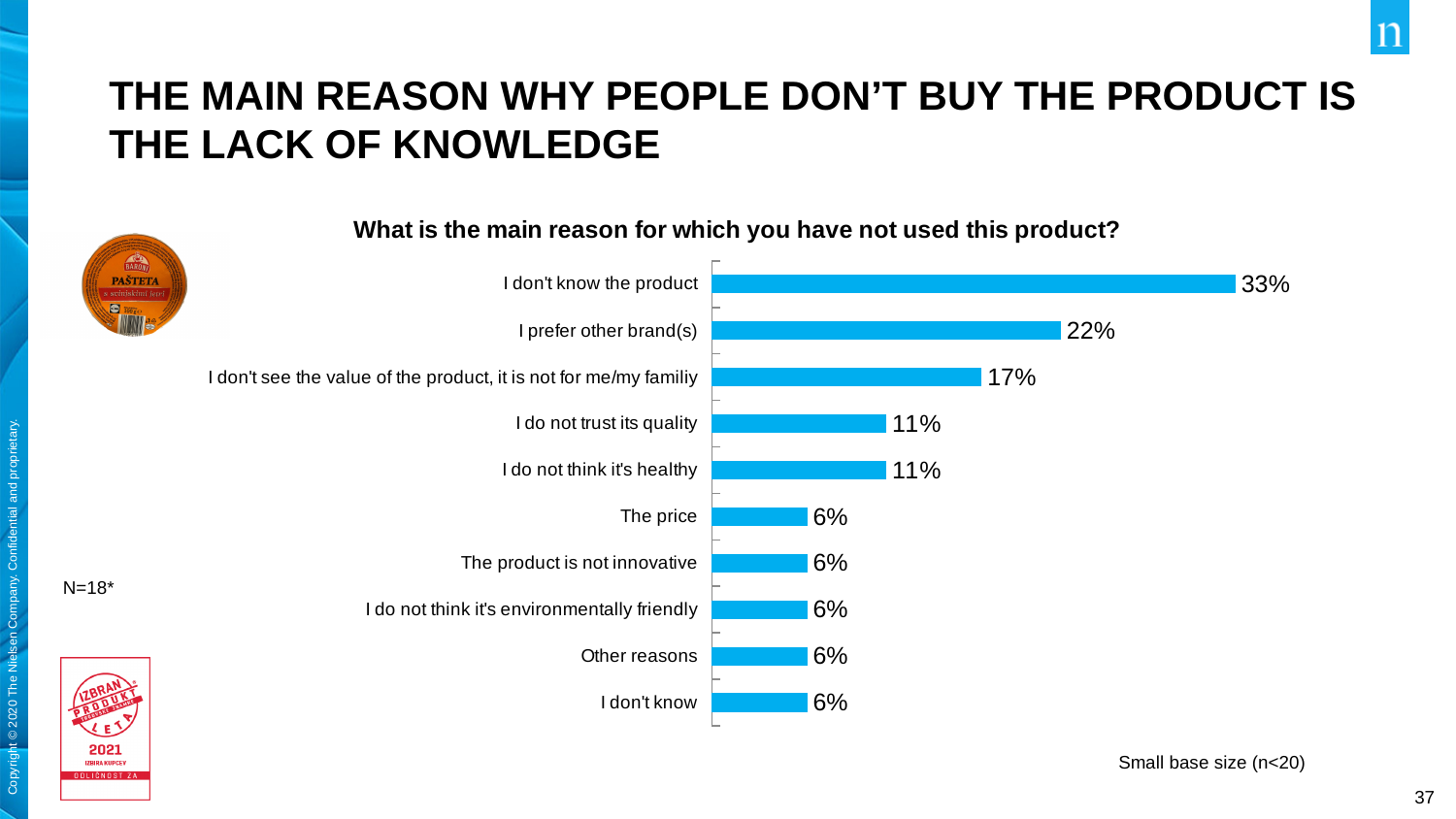
What is the difference between "I don't know the product" and "I prefer other brand(s)"? 11% Which reason has the highest percentage? I don't know the product What is the sample size (N) noted on the slide for this chart? N=18* What is the value for "I prefer other brand(s)"? 22% How many reasons (categories) are shown in the chart? 10 What is the title of the chart? What is the main reason for which you have not used this product? Which is larger: "I do not trust its quality" or "The product is not innovative"? I do not trust its quality What percentage chose "I do not trust its quality"? 11% What kind of chart is shown on the slide? Bar chart What is the difference between "I prefer other brand(s)" and "I don't see the value of the product, it is not for me/my familiy"? 5% What is the value for "The price"? 6% What percentage of respondents said "I don't know the product" as the main reason for not using it? 33%